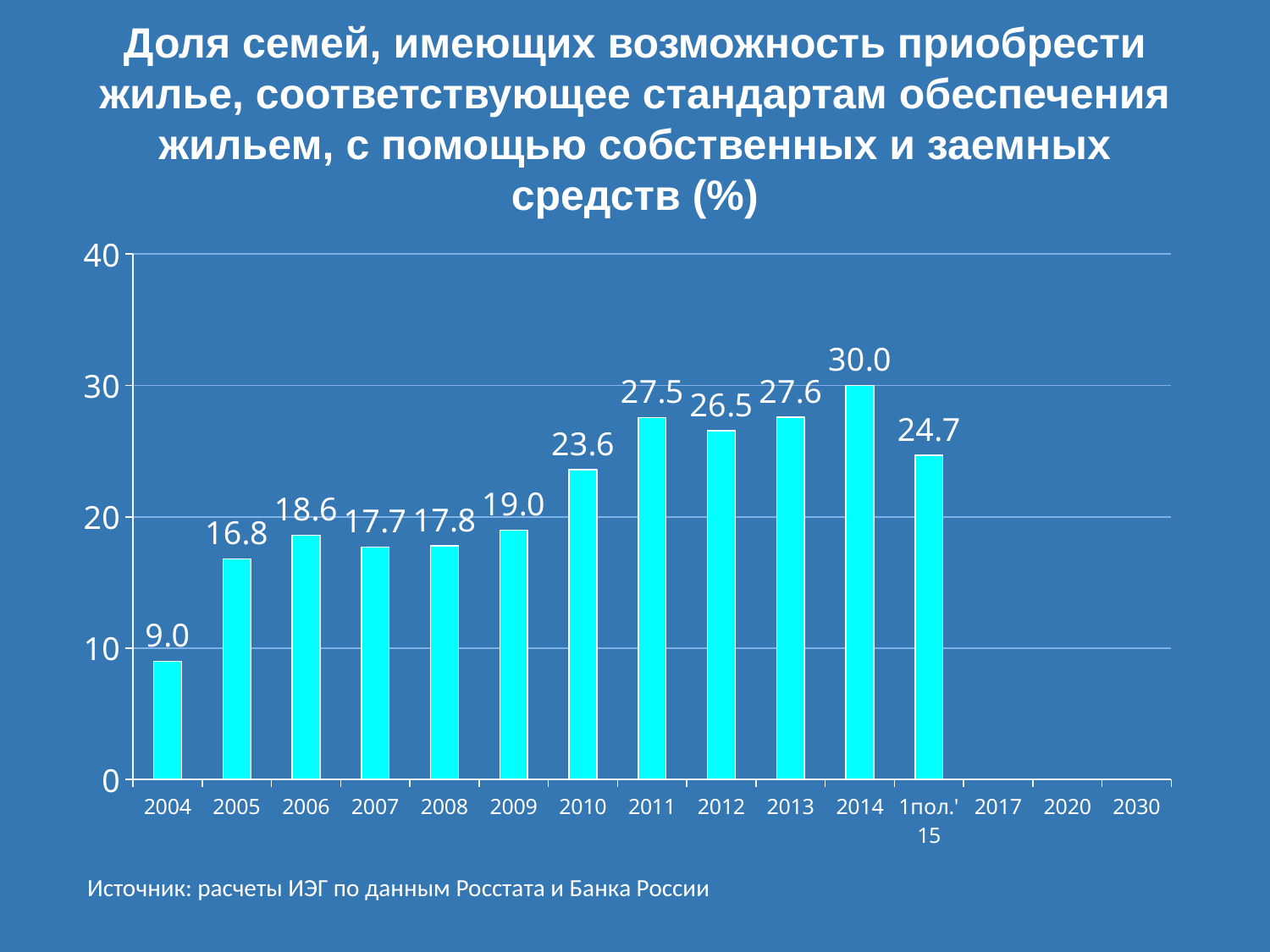
How many bars are plotted on the chart? 12 Which year has the lowest value? 2004 What is the difference between the values for 2011 and 2012? 1.0 What is the value for 2010? 23.6 What is the difference between the values for 2014 and 2004? 21.0 What type of chart is shown on the slide? bar chart Which is larger, the value for 2006 or the value for 2007? 2006 Is the value for 2009 greater or less than 20? less What is the value for 2004? 9.0 What is the value for 1пол.'15? 24.7 Which year has the highest value? 2014 Does the value rise or fall from 2004 to 2014? rise